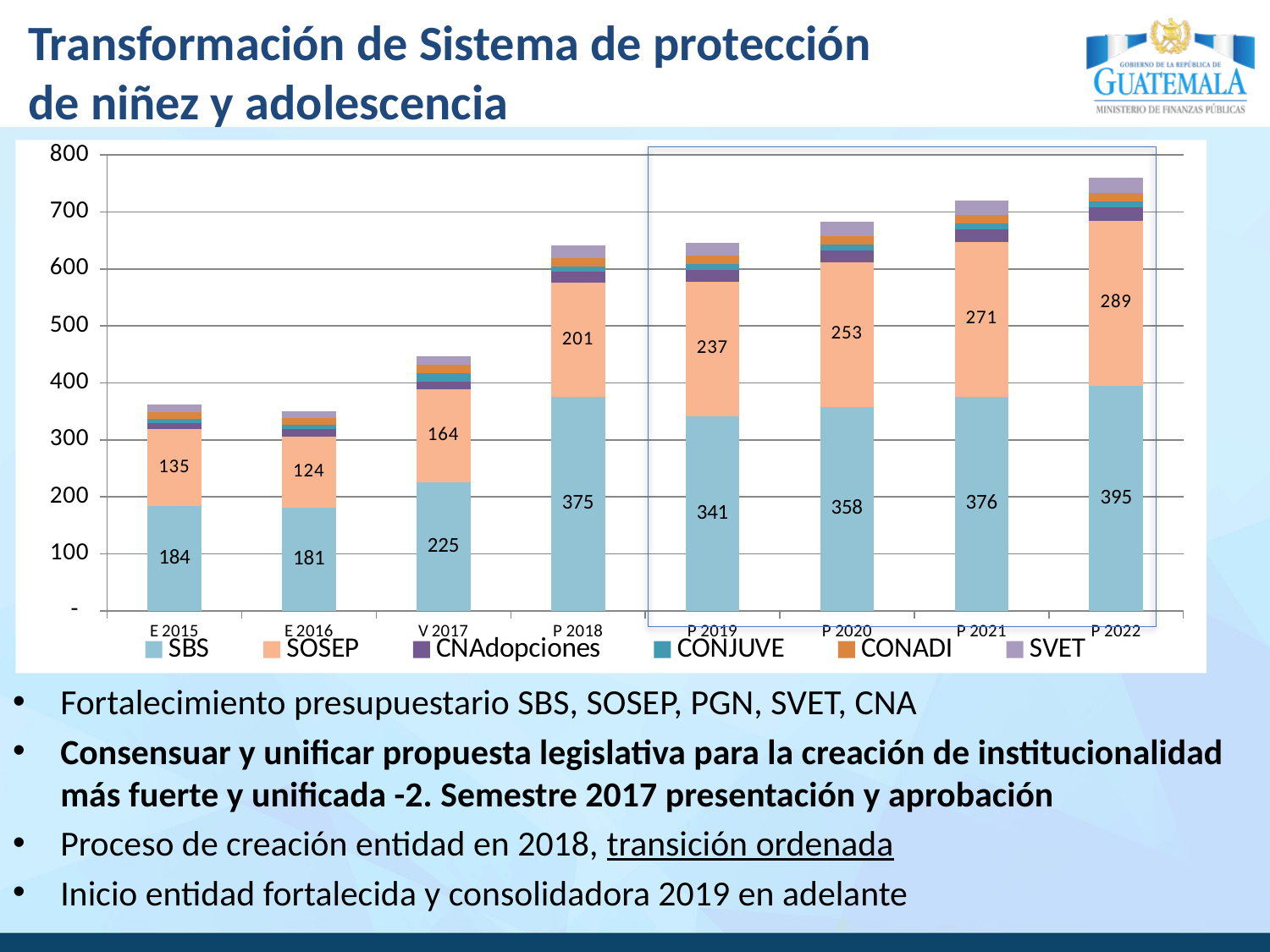
Which series is listed first in the legend? SBS Is the total height of the stacked bar for P 2022 greater or less than 700? greater How many categories are shown on the x axis? 8 What is the SOSEP value for E 2015? 135 In which category is the SBS value highest? P 2022 What is the difference between the SBS values for P 2018 and P 2019? 34 In which category is the SOSEP value lowest? E 2016 How many series does the legend list? 6 Which is larger, the SOSEP value for P 2020 or for V 2017? P 2020 Do the SOSEP values rise or fall from P 2018 to P 2022? Rise What kind of chart is shown on the slide? Stacked bar chart What is the SBS value for P 2022? 395